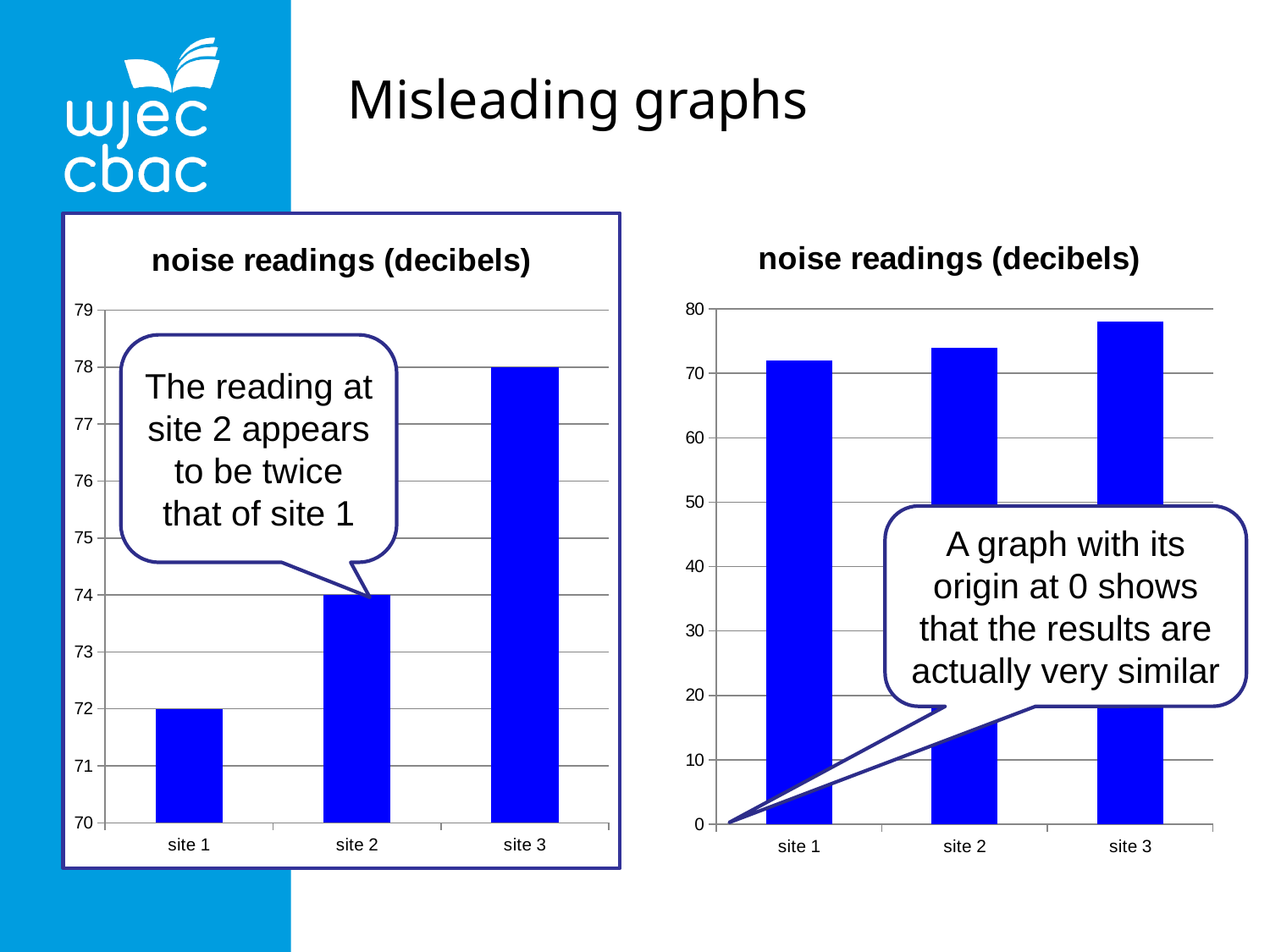
How many sites are shown in the right chart? 3 In the left chart, which site has the highest noise reading? site 3 In the left chart, what is the difference between the readings for site 3 and site 1? 6 What kind of chart is the left chart? bar chart In the left chart, what is the noise reading for site 3? 78 What value does the vertical axis of the left chart start at? 70 In the left chart, what is the noise reading for site 2? 74 In the left chart, which site has the lowest noise reading? site 1 In the right chart, is the value for site 3 greater or less than 80? less In the left chart, which is larger, the reading for site 2 or site 1? site 2 In the left chart, what is the noise reading for site 1? 72 In the right chart, is the value for site 1 greater or less than 60? greater